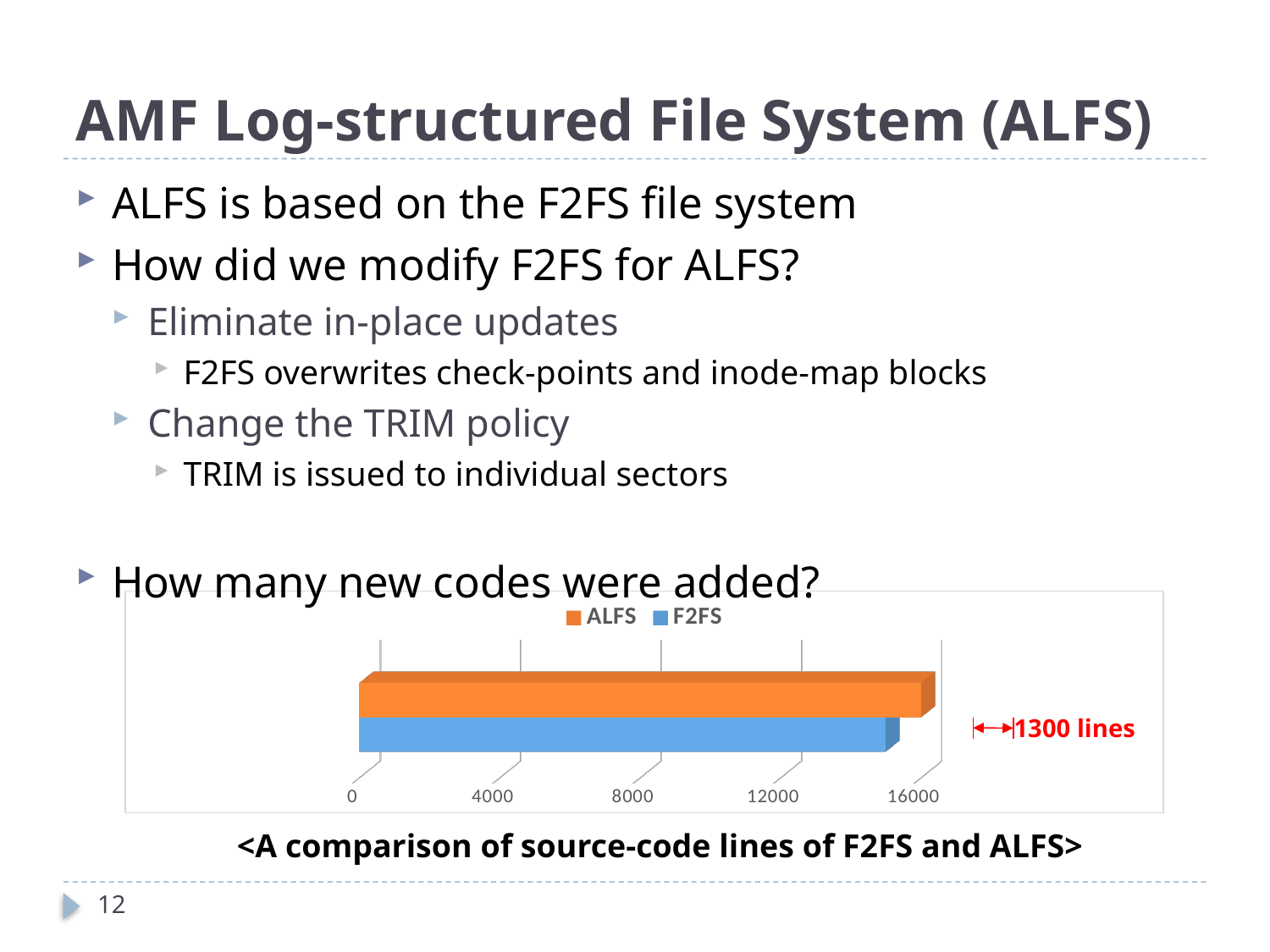
How many series does the chart legend list? 2 Which series has the longest bar in the chart? ALFS Is the value for F2FS greater or less than 12000? greater What colour is the ALFS bar in the chart? orange According to the annotation on the chart, how many more lines does ALFS have than F2FS? 1300 lines Is the value for ALFS greater or less than 12000? greater What kind of chart is shown on the slide? bar chart How many bars are plotted in the chart? 2 Which series has the shortest bar in the chart? F2FS What is the caption shown below the chart? <A comparison of source-code lines of F2FS and ALFS> Which series has the longer bar, ALFS or F2FS? ALFS Is the value for F2FS greater or less than 16000? less